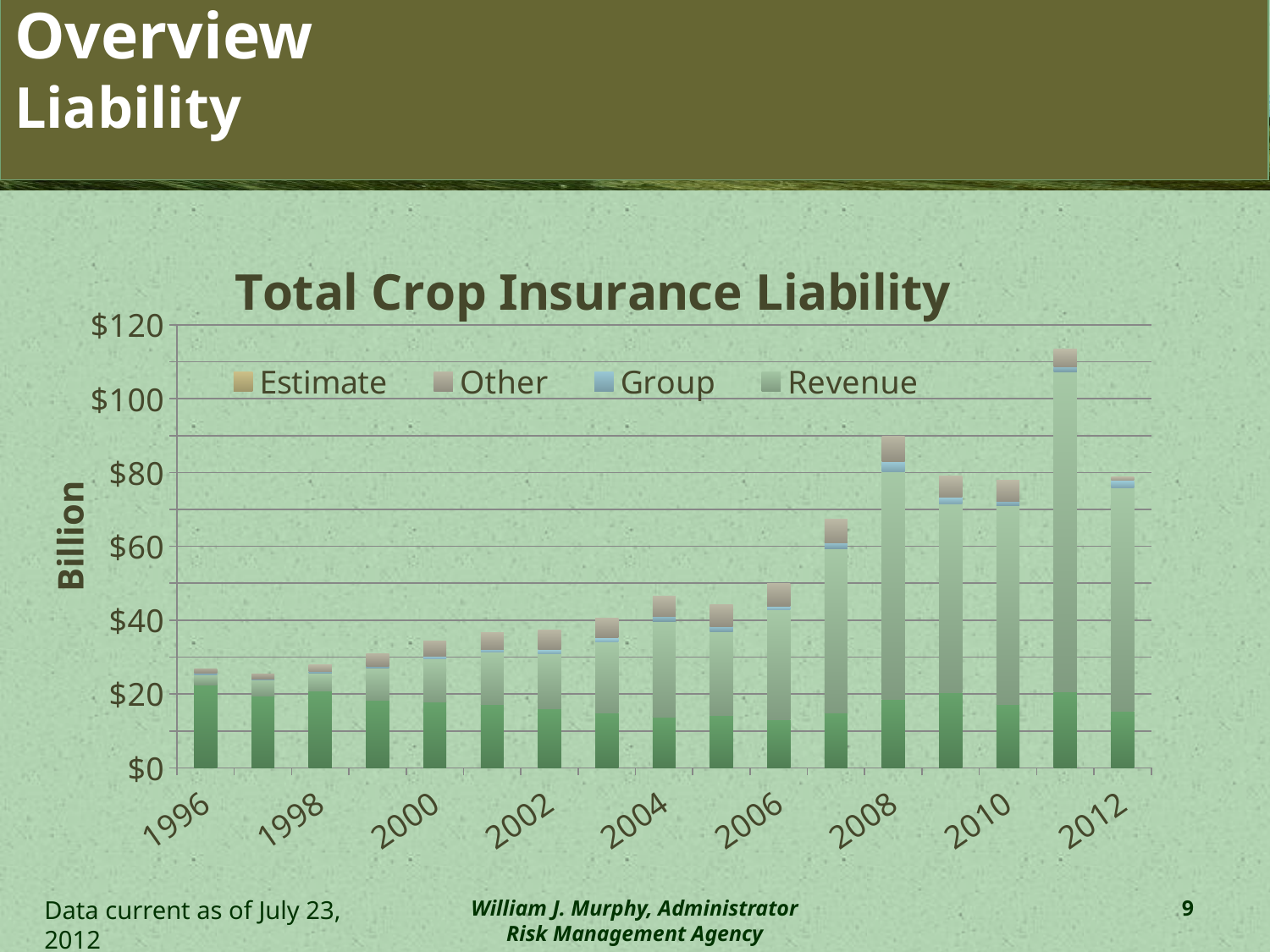
Which year has the highest total crop insurance liability? 2011 What is the title of the chart? Total Crop Insurance Liability How many years (bars) are plotted in the chart? 17 What is the label on the vertical axis? Billion Is the total liability for 2006 greater or less than $60 billion? less Is the total liability for 2008 greater or less than $80 billion? greater Is the total liability for 2011 greater or less than $100 billion? greater How many series does the legend list? 4 Which year has the larger total liability, 2008 or 2009? 2008 What kind of chart is shown on the slide? Stacked bar chart Overall, does total crop insurance liability rise or fall from 1996 to 2012? Rise